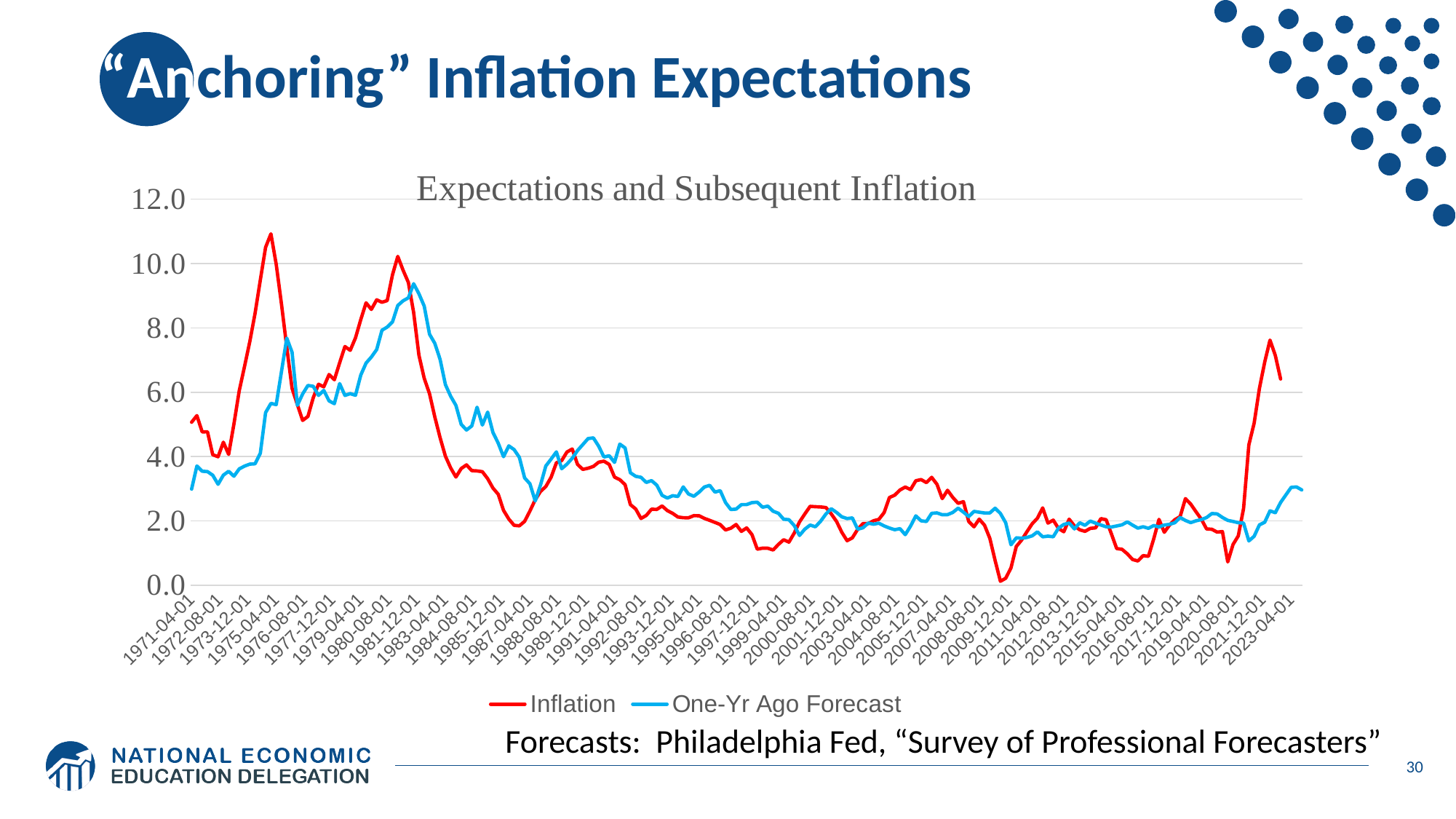
Which series reaches the highest value anywhere on the chart? Inflation Does the Inflation series rise or fall between 1981 and 1987? fall Is the peak value of the Inflation series around 1975 greater or less than 10.0? greater What kind of chart is shown on the slide? line chart How many series does the chart legend list? 2 What is the title of the chart? Expectations and Subsequent Inflation Is the lowest value of the Inflation series around 2009 greater or less than 2.0? less Is the value of the One-Yr Ago Forecast series at 2023-04-01 greater or less than 4.0? less Around 1975, which series has the higher value, Inflation or One-Yr Ago Forecast? Inflation Around 2021-2023, which series has the higher peak, Inflation or One-Yr Ago Forecast? Inflation Which series is drawn in red? Inflation